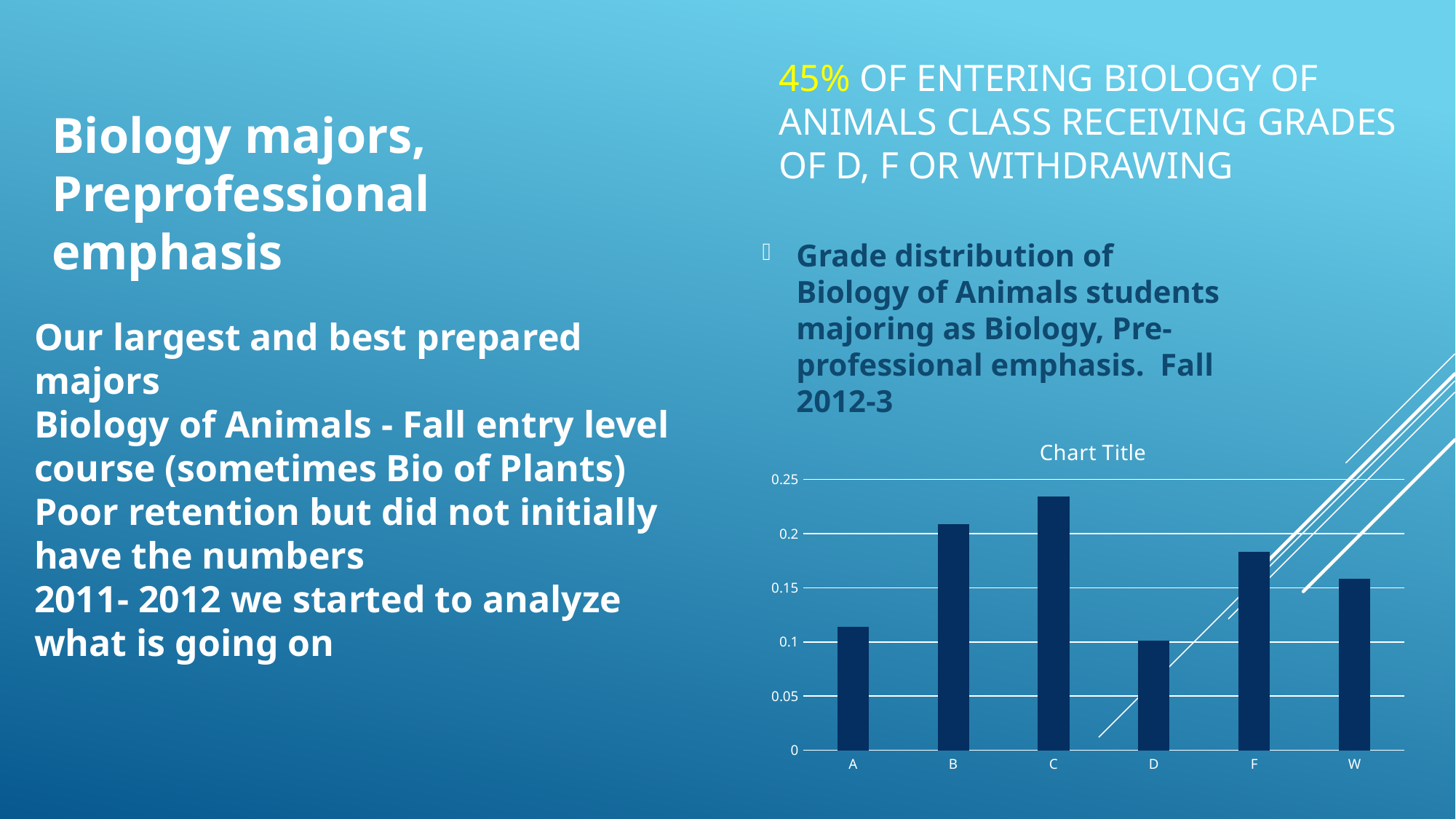
How many categories are shown on the x axis of the chart? 6 Is the value for A greater or less than 0.15? less Is the value for W greater or less than 0.2? less Is the value for D greater or less than 0.15? less Which category has the highest bar in the chart? C What is the title shown above the chart? Chart Title Which category has the lowest bar in the chart? D What kind of chart is shown on the slide? bar chart Which is larger, the value for B or the value for F? B Which is larger, the value for W or the value for C? C